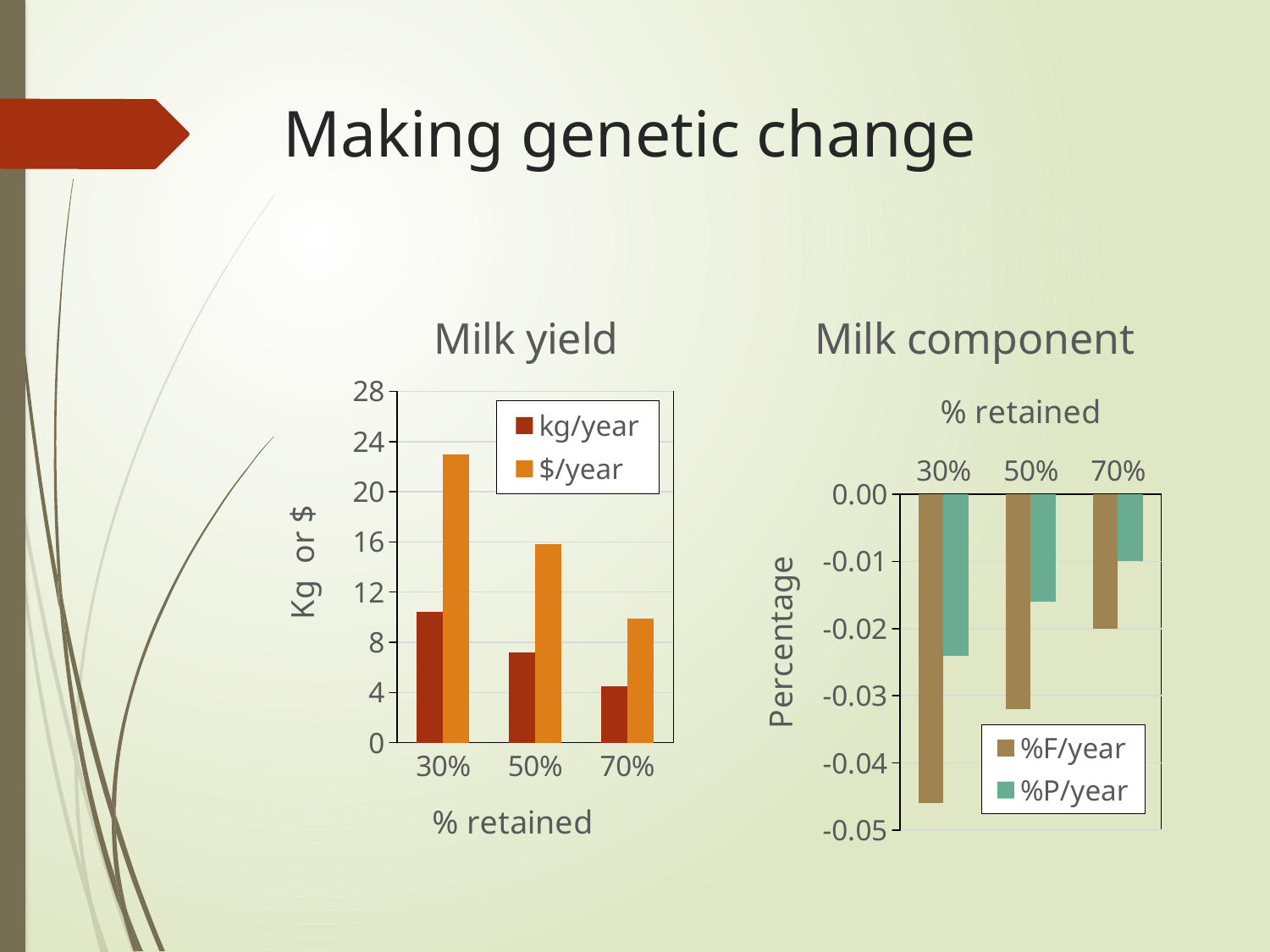
In the Milk yield chart, do the $/year values rise or fall as % retained increases from 30% to 70%? fall How many categories are shown on the x axis of the Milk yield chart? 3 In the Milk yield chart, is the $/year value for 30% retained greater or less than 20? greater How many series does the legend of the Milk component chart list? 2 In the Milk component chart, which % retained category has the lowest (most negative) %F/year value? 30% In the Milk yield chart, which % retained category has the highest $/year value? 30% In the Milk component chart, is the %P/year value for 30% retained greater or less than -0.02? less In the Milk yield chart, is the kg/year value for 50% retained greater or less than 8? less What type of chart is the Milk yield chart? bar chart What are the two legend entries of the Milk yield chart? kg/year and $/year In the Milk yield chart, which % retained category has the lowest kg/year value? 70% In the Milk yield chart, which is larger at 50% retained, kg/year or $/year? $/year